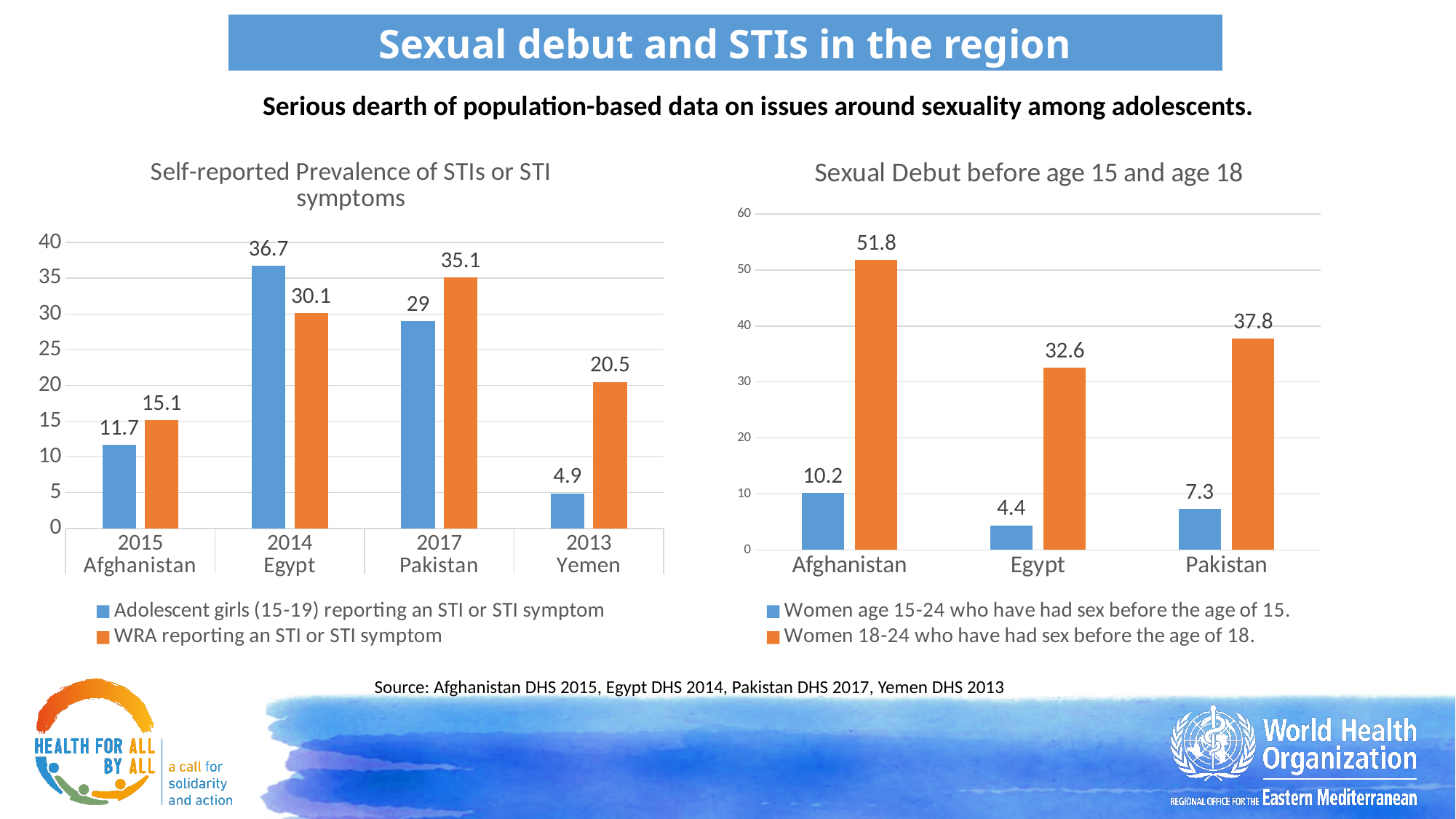
In the 'Self-reported Prevalence of STIs or STI symptoms' chart, what is the value for WRA reporting an STI or STI symptom in Yemen? 20.5 In the 'Sexual Debut before age 15 and age 18' chart, how many series does the legend list? 2 In the 'Sexual Debut before age 15 and age 18' chart, which country has the highest value for women 18-24 who have had sex before the age of 18? Afghanistan In the 'Self-reported Prevalence of STIs or STI symptoms' chart, which country has the lowest value for adolescent girls (15-19) reporting an STI or STI symptom? Yemen What kind of chart is the 'Sexual Debut before age 15 and age 18' chart? Bar chart In the 'Self-reported Prevalence of STIs or STI symptoms' chart, how many countries are shown on the x axis? 4 In the 'Sexual Debut before age 15 and age 18' chart, what is the difference between the before-age-18 value and the before-age-15 value for Pakistan? 30.5 In the 'Self-reported Prevalence of STIs or STI symptoms' chart, what is the difference between the WRA value and the adolescent girls value for Pakistan? 6.1 In the 'Sexual Debut before age 15 and age 18' chart, what is the value for women 18-24 who have had sex before the age of 18 in Afghanistan? 51.8 In the 'Sexual Debut before age 15 and age 18' chart, which country has the lowest value for women age 15-24 who have had sex before the age of 15? Egypt In the 'Self-reported Prevalence of STIs or STI symptoms' chart, what is the value for adolescent girls (15-19) reporting an STI or STI symptom in Egypt? 36.7 In the 'Self-reported Prevalence of STIs or STI symptoms' chart, which is larger for Egypt: the adolescent girls value or the WRA value? Adolescent girls (15-19) reporting an STI or STI symptom